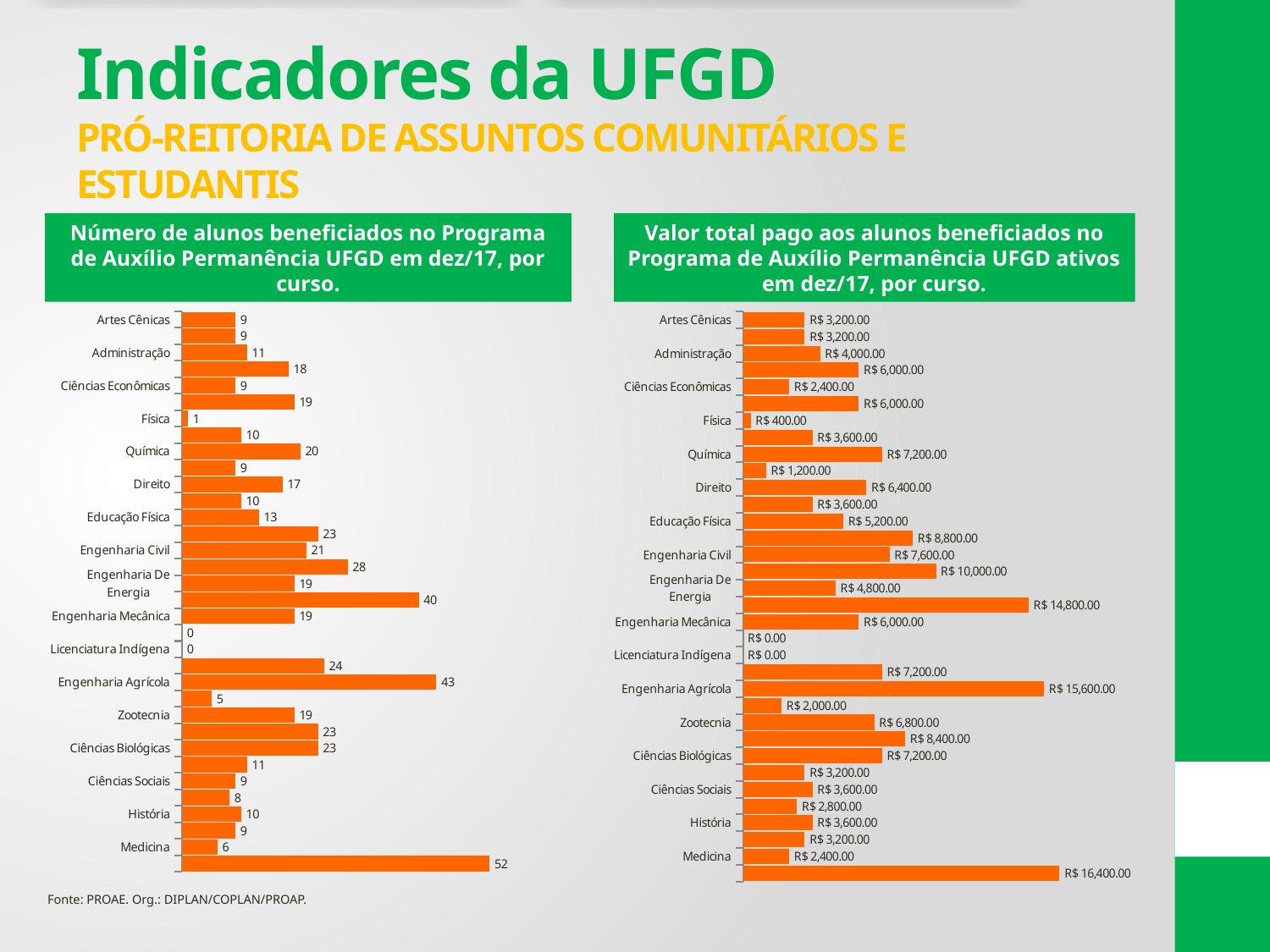
In the right chart (Valor total pago), what is the value for Física? R$ 400.00 In the right chart (Valor total pago), what is the largest value labelled on any bar? R$ 16,400.00 In the left chart (Número de alunos beneficiados), how many students are shown for Química? 20 In the left chart (Número de alunos beneficiados), what is the difference between the values for Química and Direito? 3 What colour are the bars in both charts? Orange In the left chart (Número de alunos beneficiados), what is the value for Engenharia Agrícola? 43 In the right chart (Valor total pago), what is the difference between the values for Engenharia Civil and Educação Física? R$ 2,400.00 What type of chart is used on the left side of the slide? Bar chart In the right chart (Valor total pago), which is larger: the value for Química or the value for Direito? Química In the left chart (Número de alunos beneficiados), what is the largest value labelled on any bar? 52 In the right chart (Valor total pago), what is the value for Engenharia Agrícola? R$ 15,600.00 In the left chart (Número de alunos beneficiados), what is the value for Licenciatura Indígena? 0